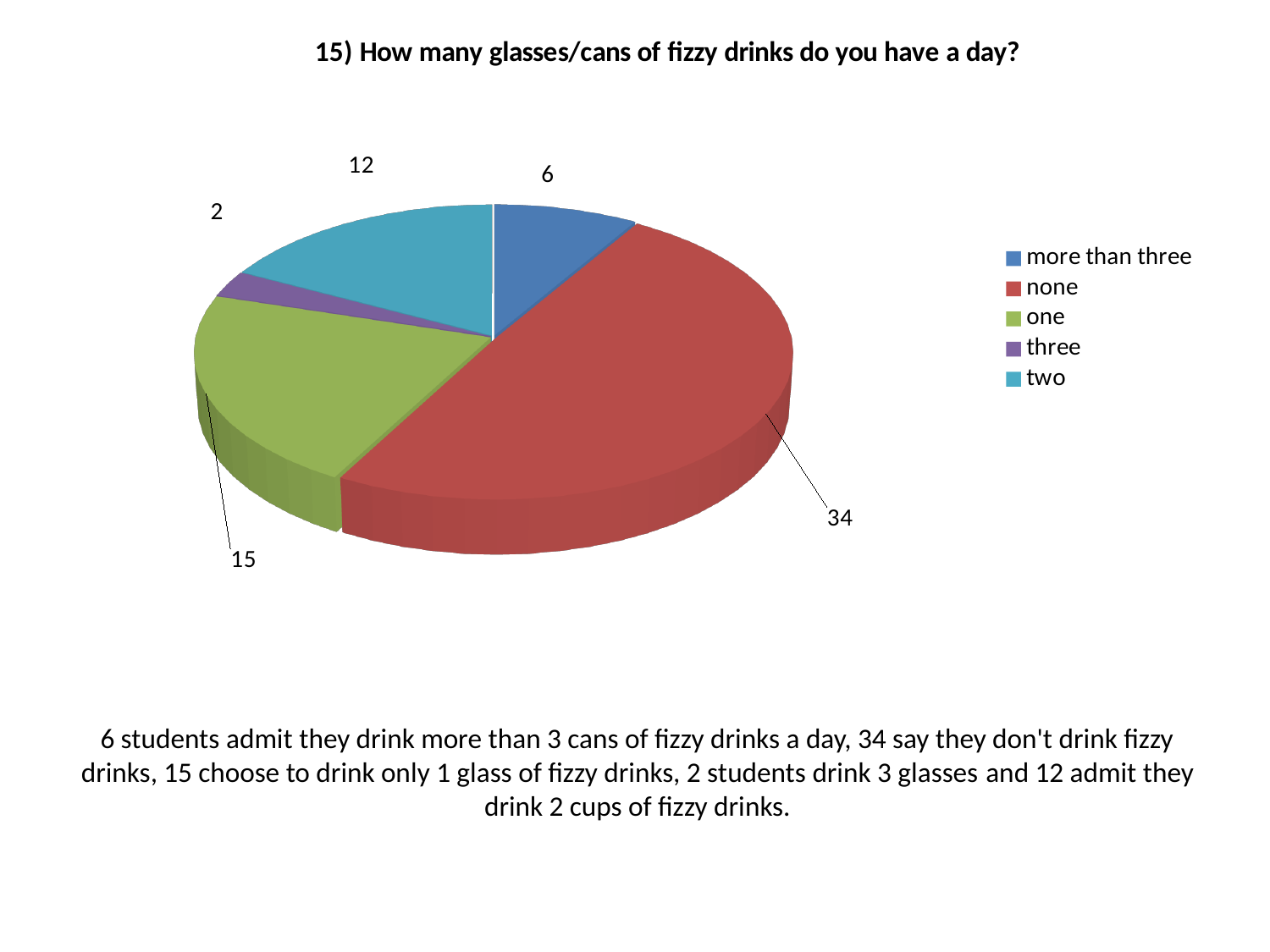
What is the value for the 'three' slice in the pie chart? 2 What is the value for the 'one' slice in the pie chart? 15 What colour is the 'none' slice in the pie chart? red Which category has the smallest slice in the pie chart? three What type of chart is shown on the slide? pie chart How many slices does the pie chart have? 5 Which category has the largest slice in the pie chart? none Which is larger, the value for 'two' or the value for 'more than three'? two What is the value for the 'two' slice in the pie chart? 12 What is the value for the 'more than three' slice in the pie chart? 6 What is the value for the 'none' slice in the pie chart? 34 What is the difference between the 'none' value and the 'one' value? 19